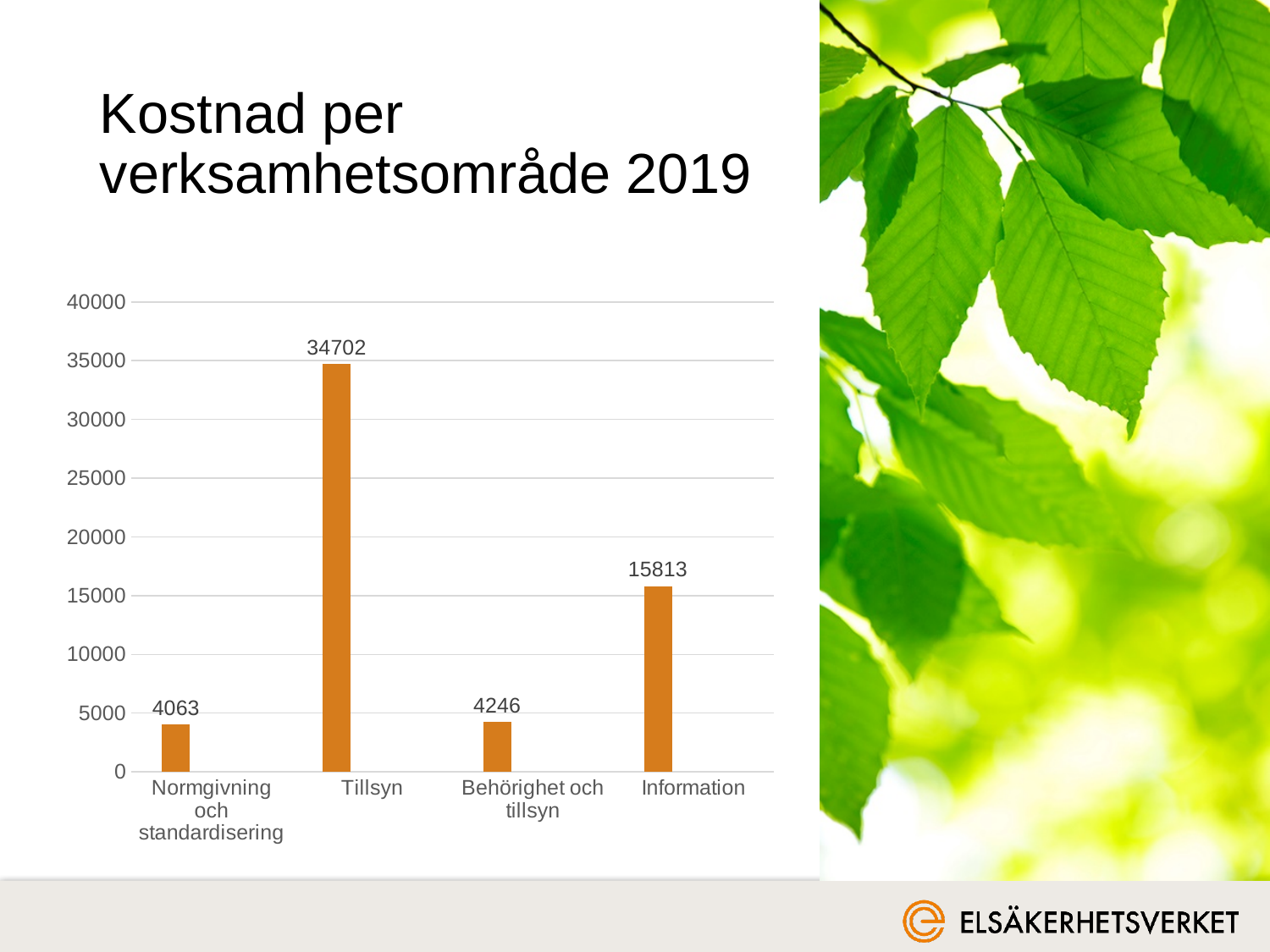
How many categories are shown in the chart? 4 What is the value for Tillsyn? 34702 Which category has the highest value? Tillsyn What is the difference between the values for Behörighet och tillsyn and Normgivning och standardisering? 183 Which category has the lowest value? Normgivning och standardisering What is the difference between the values for Tillsyn and Information? 18889 What kind of chart is shown on the slide? Bar chart Is the value for Tillsyn greater or less than 30000? greater Which is larger, the value for Information or the value for Behörighet och tillsyn? Information What is the value for Behörighet och tillsyn? 4246 What is the value for Normgivning och standardisering? 4063 What is the value for Information? 15813